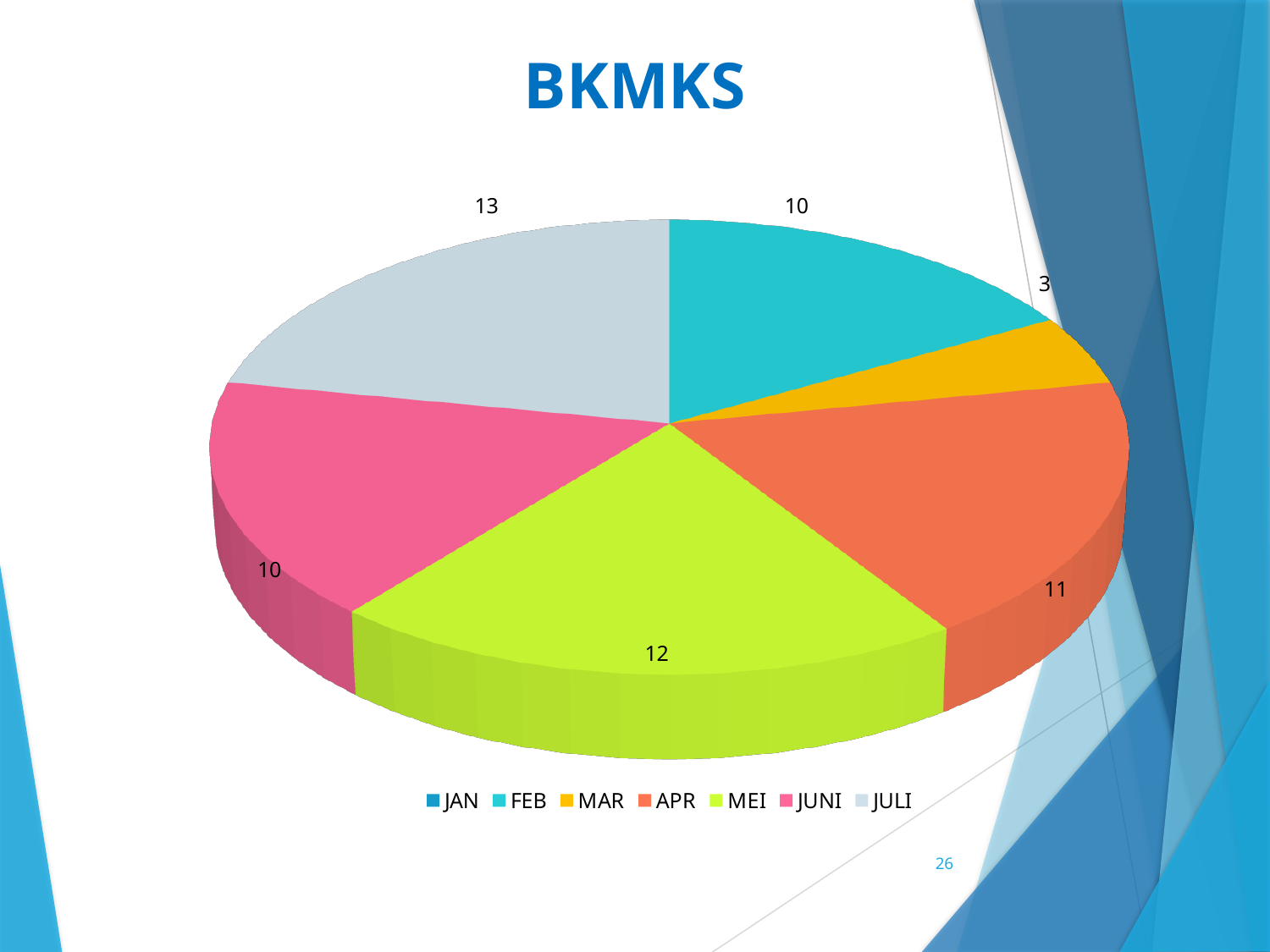
Which category has the smallest visible slice? MAR What kind of chart is shown on the slide? pie chart What is the difference between the values for JULI and MAR? 10 How many categories does the legend list? 7 Which is larger, the value for MEI or the value for APR? MEI Which category has the largest slice? JULI What is the value for MEI? 12 What is the title of the chart? BKMKS What is the value for JULI? 13 What is the value for APR? 11 What is the value for MAR? 3 What is the value for FEB? 10